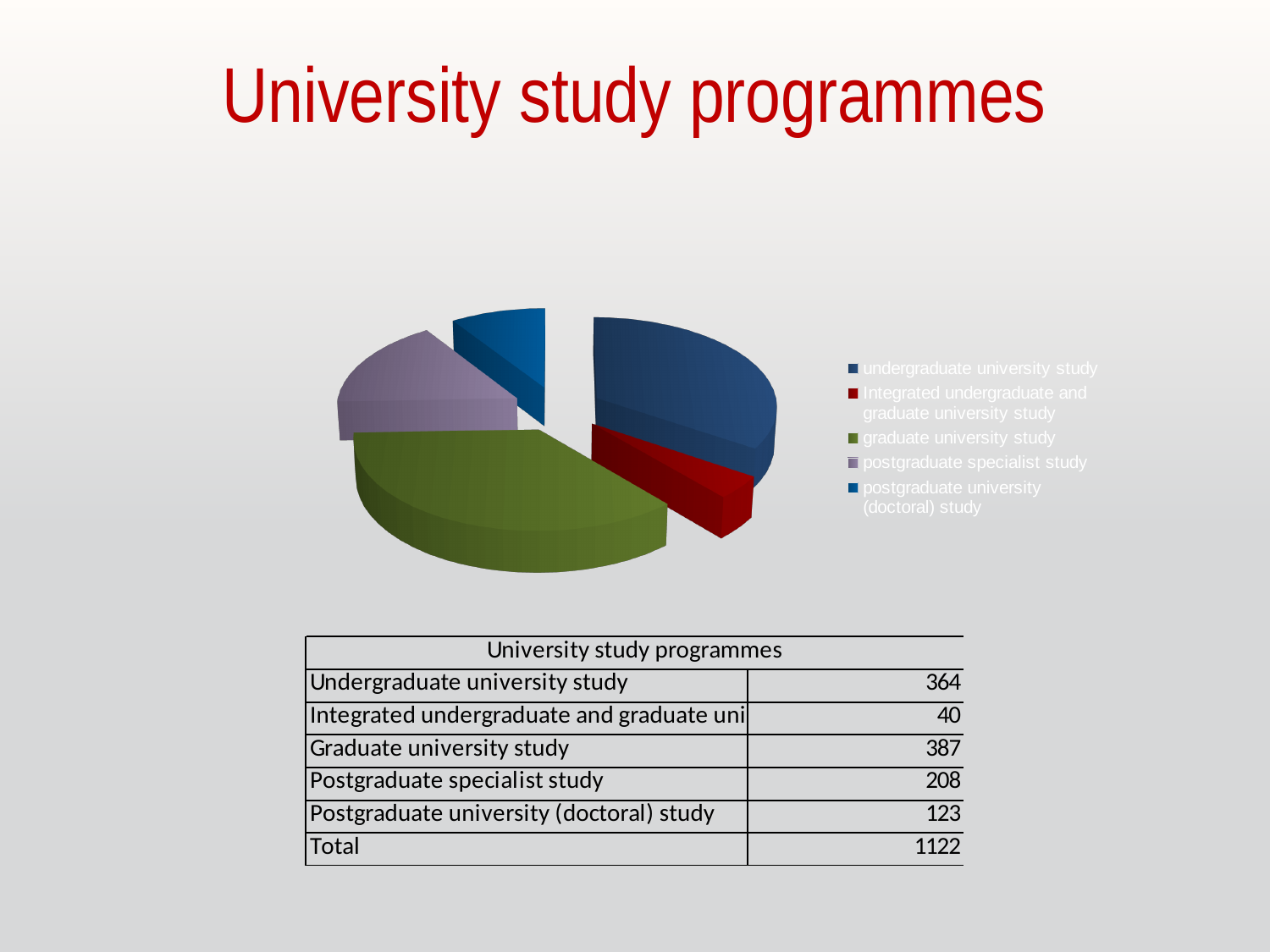
What is the difference between Graduate university study and Undergraduate university study? 23 Which is larger, Postgraduate specialist study or Postgraduate university (doctoral) study? Postgraduate specialist study Which study programme has the lowest value? Integrated undergraduate and graduate university study What is the total across all university study programmes? 1122 What is the value for Graduate university study? 387 What kind of chart is shown on the slide? pie chart Which study programme has the highest value? Graduate university study What is the difference between Postgraduate specialist study and Postgraduate university (doctoral) study? 85 What is the value for Postgraduate specialist study? 208 What is the value for Postgraduate university (doctoral) study? 123 What is the value for Undergraduate university study? 364 How many study programme categories does the pie chart show? 5